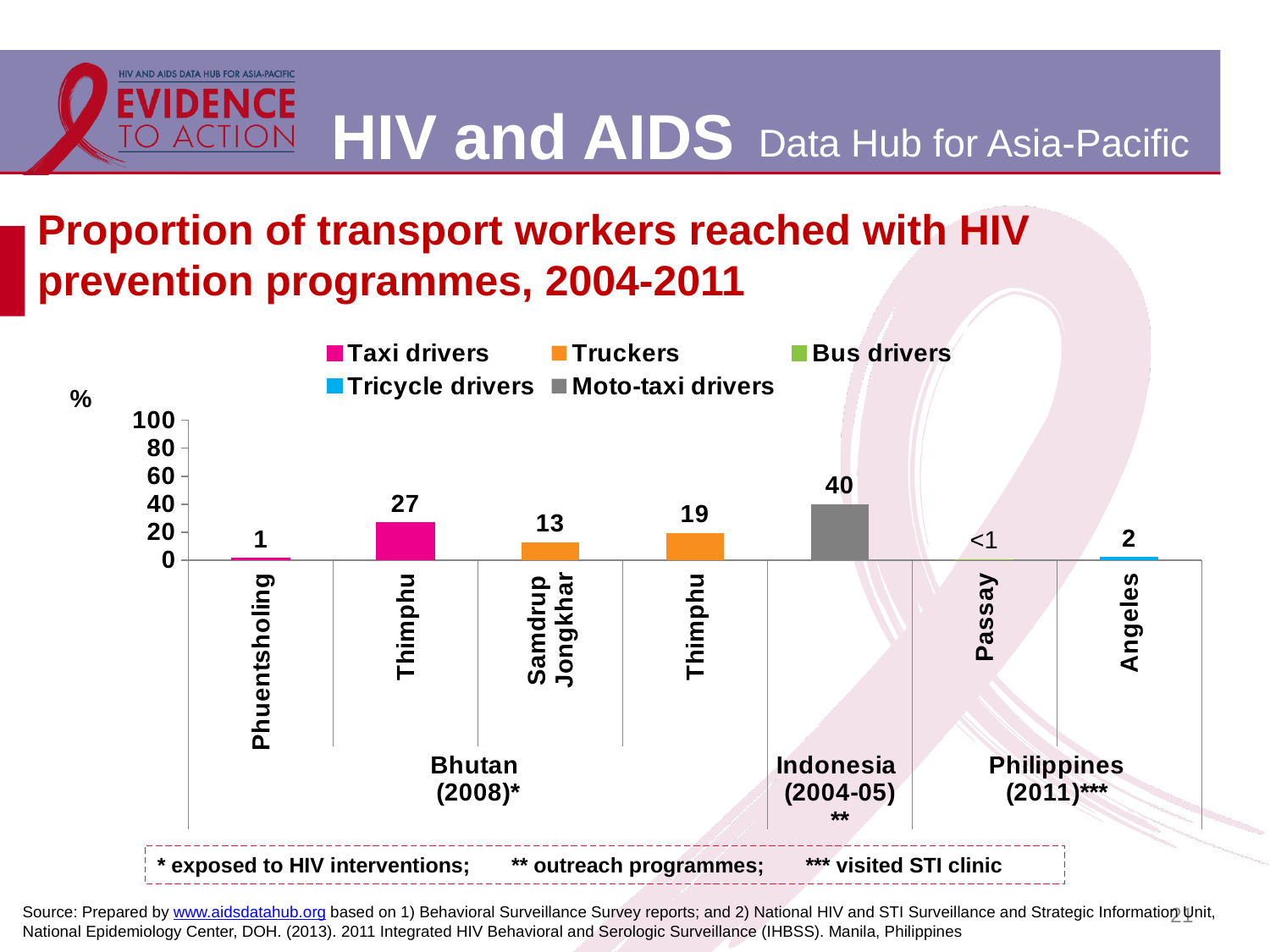
Which is larger, the value for Samdrup Jongkhar or the value for Angeles? Samdrup Jongkhar What is the value shown for Passay? <1 What is the value for moto-taxi drivers in Indonesia (2004-05)? 40 What unit is shown on the y axis? % What is the value for Phuentsholing? 1 What kind of chart is shown on the slide? bar chart How many bars (data points) are plotted in the chart? 7 Which bar has the highest value? Indonesia (2004-05), moto-taxi drivers What is the value for Angeles in the Philippines? 2 What is the value for Samdrup Jongkhar? 13 What is the difference between the taxi drivers value for Thimphu and the truckers value for Thimphu? 8 How many series does the legend list? 5